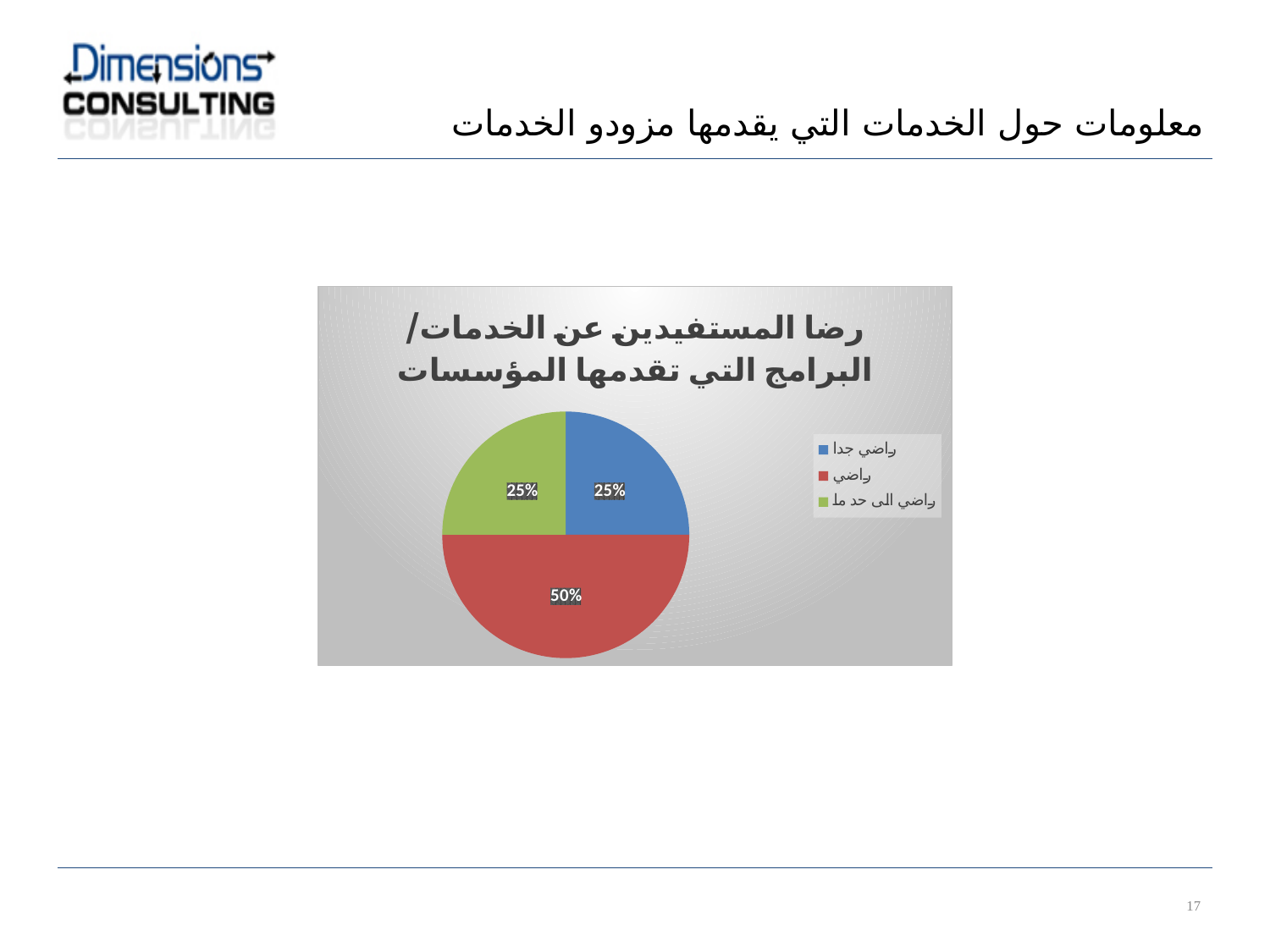
What share of the pie does the "راضي الى حد ما" slice represent? 25% How many entries does the legend list? 3 Which is larger, the "راضي" slice or the "راضي الى حد ما" slice? راضي Which category has the largest slice of the pie? راضي What share of the pie does the "راضي جدا" slice represent? 25% How many slices does the pie chart have? 3 What kind of chart is shown on the slide? pie chart What is the title of the pie chart? رضا المستفيدين عن الخدمات/ البرامج التي تقدمها المؤسسات What share of the pie does the "راضي" slice represent? 50% What colour is the "راضي" slice in the pie chart? red What is the combined share of the "راضي جدا" and "راضي الى حد ما" slices? 50% What is the difference between the "راضي" share and the "راضي جدا" share? 25%